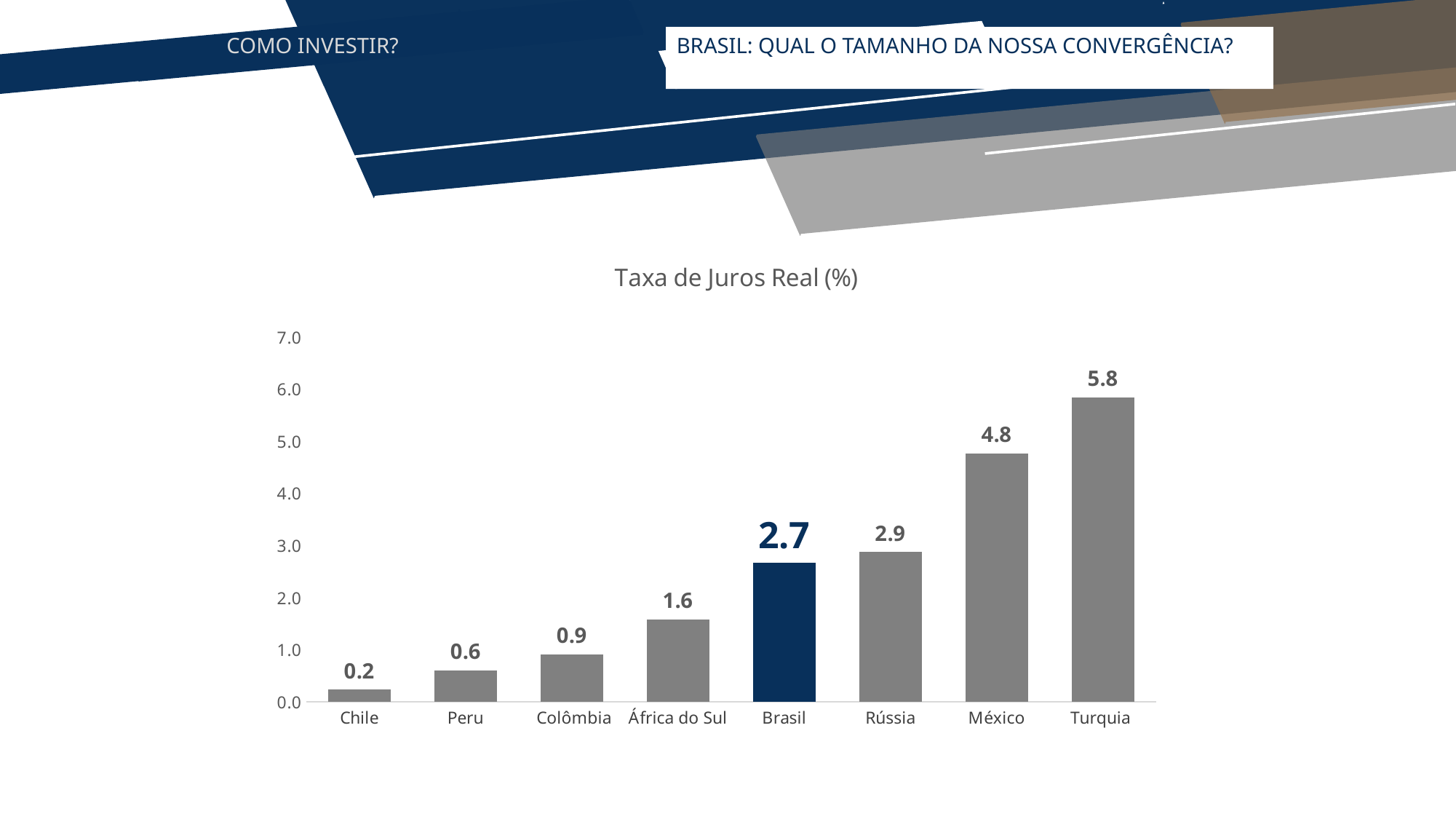
Which is larger, the value for Rússia or the value for Colômbia? Rússia What is the difference between the values for México and Brasil? 2.1 What is the value for Brasil? 2.7 What is the title of the chart? Taxa de Juros Real (%) Which country has the lowest real interest rate? Chile How many countries are shown in the chart? 8 Is the value for México greater or less than 4.0? greater What is the value for África do Sul? 1.6 What kind of chart is shown on the slide? Bar chart What is the value for Turquia? 5.8 Do the values rise or fall from left to right along the x axis? Rise Which country has the highest real interest rate? Turquia